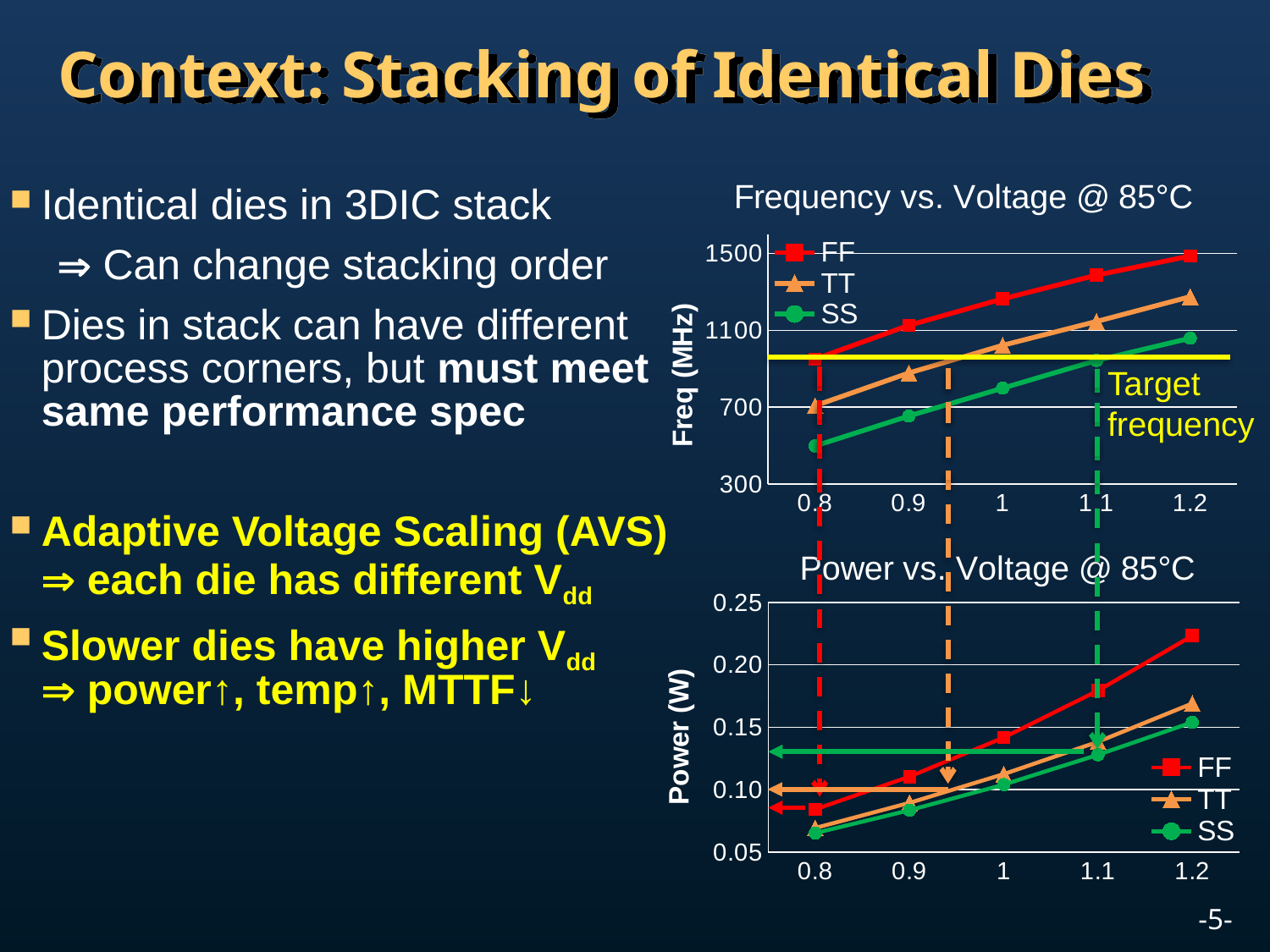
In the Frequency vs. Voltage @ 85°C chart, is the SS frequency at 0.8 V greater or less than 700 MHz? less How many series does the legend of the Power vs. Voltage @ 85°C chart list? 3 What is the title of the lower chart on the slide? Power vs. Voltage @ 85°C In the Frequency vs. Voltage @ 85°C chart, which series has the lowest frequency at 0.8 V? SS In the Power vs. Voltage @ 85°C chart, is the SS power at 0.8 V greater or less than 0.10 W? less In the Frequency vs. Voltage @ 85°C chart, does frequency rise or fall as voltage increases? Rises In the Power vs. Voltage @ 85°C chart, which series has higher power at 1.2 V, FF or SS? FF What type of chart is the Frequency vs. Voltage @ 85°C chart? Line chart In the Frequency vs. Voltage @ 85°C chart, is the FF frequency at 1.2 V greater or less than 1100 MHz? greater In the Frequency vs. Voltage @ 85°C chart, which series has the highest frequency at 1.2 V? FF In the Frequency vs. Voltage @ 85°C chart, how many voltage points are plotted for the FF series? 5